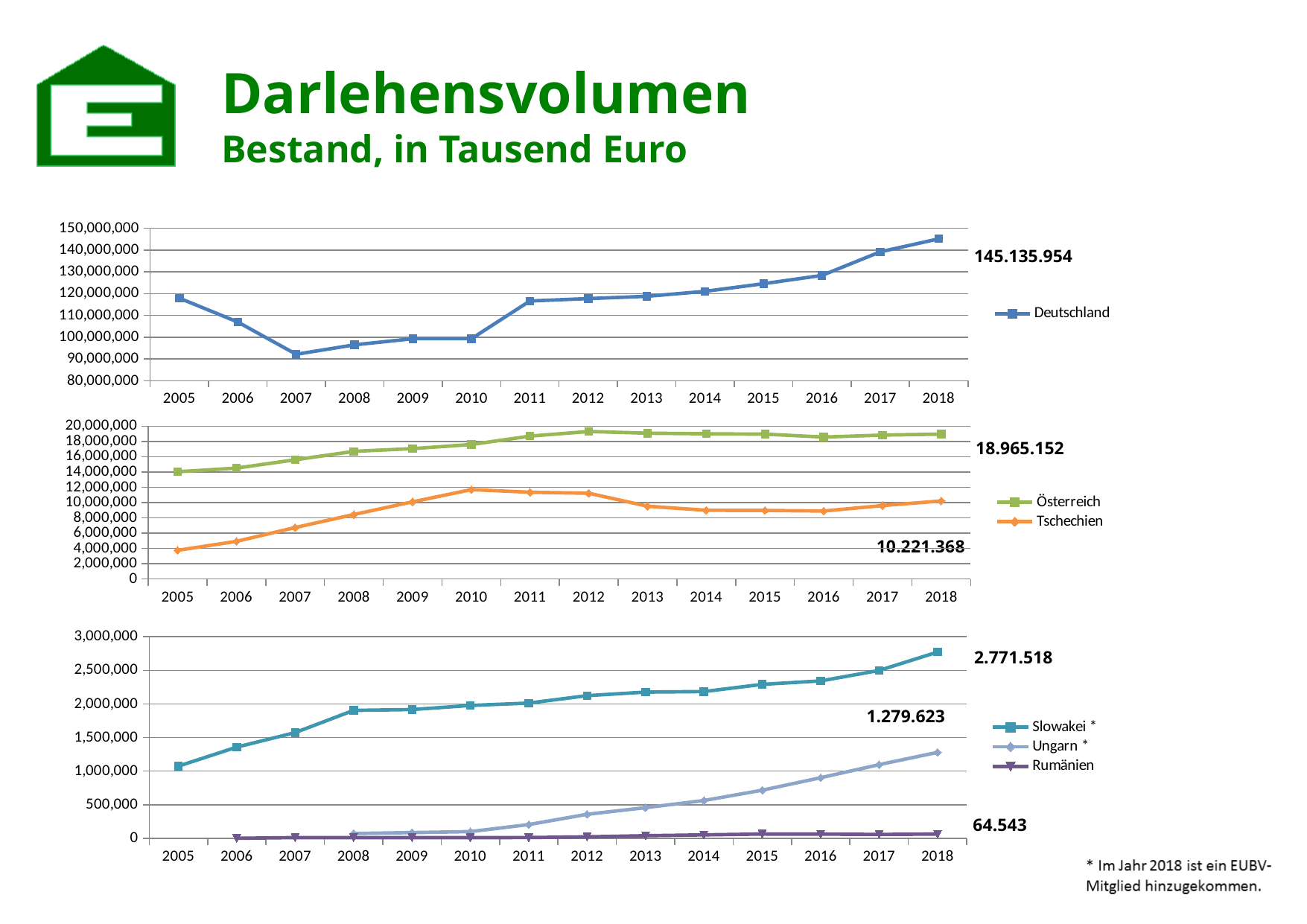
In the middle chart, what is the value for Tschechien in 2018? 10.221.368 In the bottom chart, what is the value for Ungarn in 2018? 1.279.623 What kind of chart is the bottom chart? line chart In the bottom chart, what is the value for Slowakei in 2018? 2.771.518 In the middle chart, what is the value for Österreich in 2018? 18.965.152 In the bottom chart, how many series does the legend list? 3 In the top chart, what is the value for Deutschland in 2018? 145.135.954 In the top chart, is the value for Deutschland in 2007 greater or less than 100,000,000? less In the bottom chart, what is the value for Rumänien in 2018? 64.543 In the middle chart, which year has the highest value for Tschechien? 2010 In the bottom chart, does the value for Slowakei rise or fall from 2005 to 2018? rise In the top chart, which year has the lowest value for Deutschland? 2007